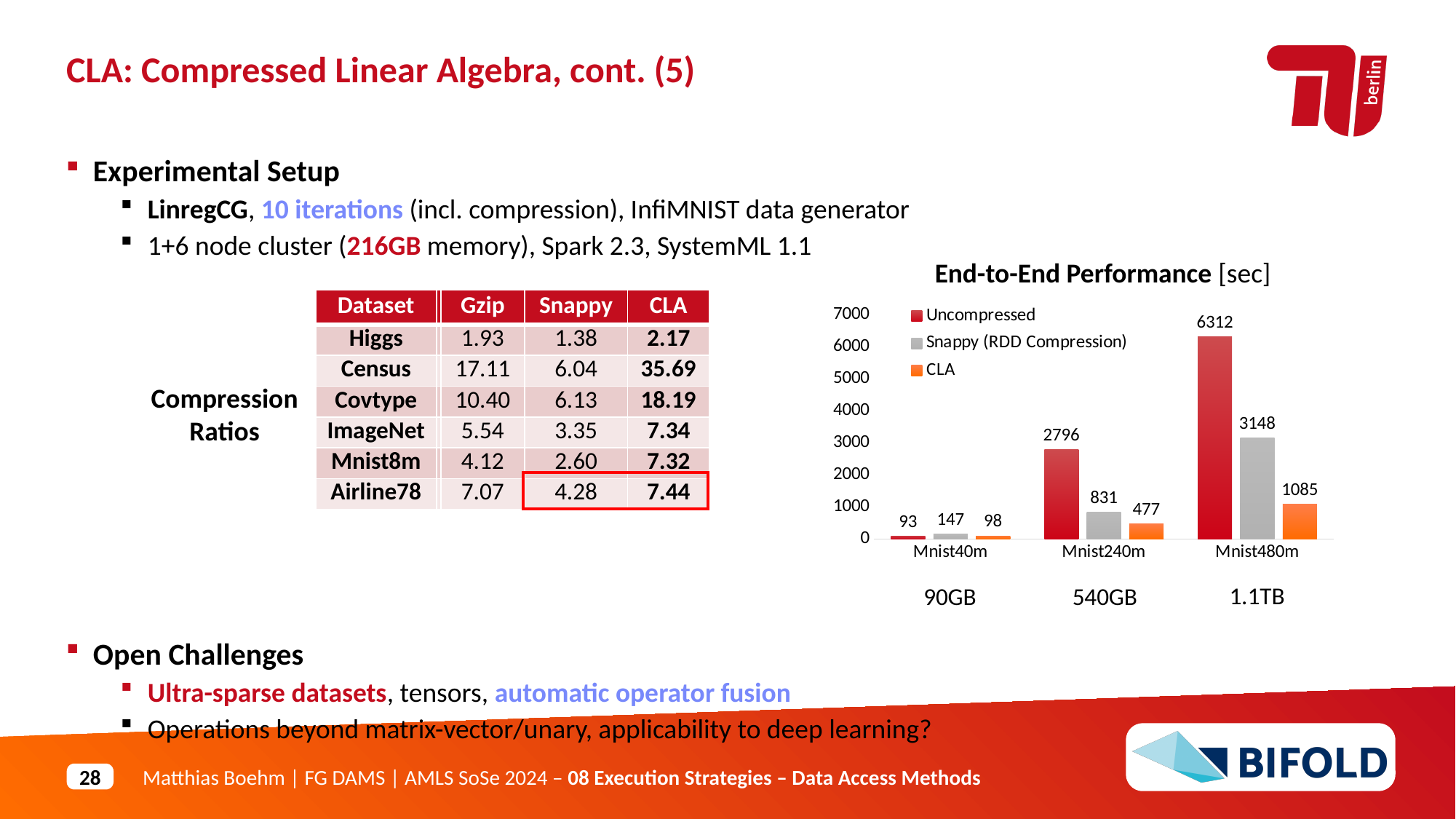
What is the value for Uncompressed at Mnist480m in the End-to-End Performance chart? 6312 Which category has the highest Uncompressed value in the End-to-End Performance chart? Mnist480m What is the value for CLA at Mnist240m in the End-to-End Performance chart? 477 How many series does the legend of the End-to-End Performance chart list? 3 In the End-to-End Performance chart, do the Uncompressed values rise or fall from Mnist40m to Mnist480m? rise What kind of chart is the End-to-End Performance chart? bar chart Which category has the lowest CLA value in the End-to-End Performance chart? Mnist40m What is the value for Snappy (RDD Compression) at Mnist40m in the End-to-End Performance chart? 147 How many categories are shown on the x axis of the End-to-End Performance chart? 3 In the End-to-End Performance chart, is the Snappy (RDD Compression) value at Mnist480m greater or less than 3000? greater In the End-to-End Performance chart, which is larger at Mnist240m: Snappy (RDD Compression) or CLA? Snappy (RDD Compression) What is the difference between the Uncompressed and CLA values at Mnist480m in the End-to-End Performance chart? 5227